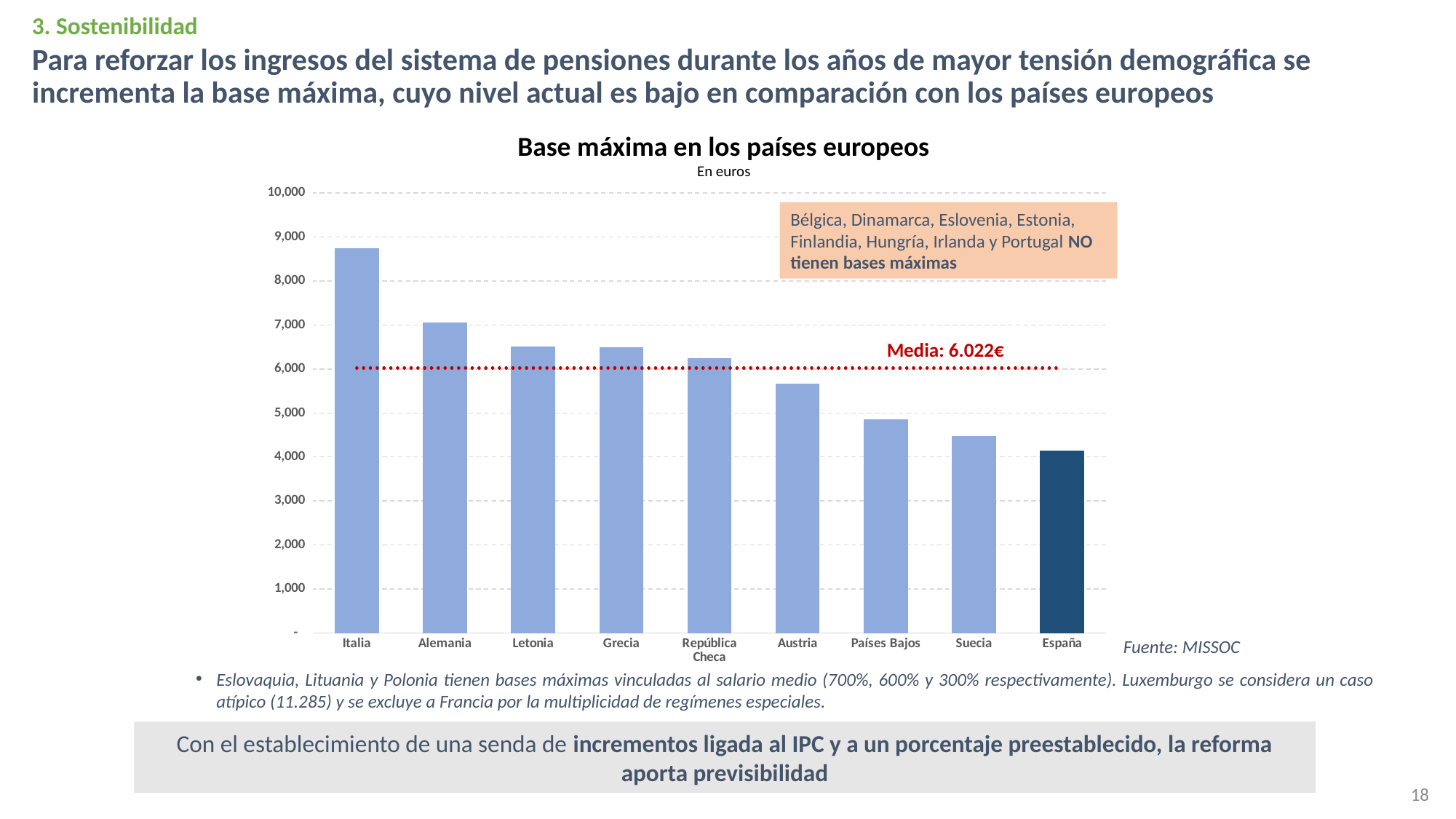
What is the title of the chart? Base máxima en los países europeos What is the value of the 'Media' marked by the dotted line in the chart? 6.022€ How many countries are plotted in the chart 'Base máxima en los países europeos'? 9 Is the value for España greater or less than 5,000? less Which country has the highest base máxima in the chart? Italia Which country has the lowest base máxima in the chart? España Which is larger, the value for Austria or the value for Países Bajos? Austria Do the bar values rise or fall from left to right across the chart? Fall Is the value for Austria greater or less than 6,000? less What kind of chart is shown on the slide? Bar chart Is the value for Italia greater or less than 8,000? greater